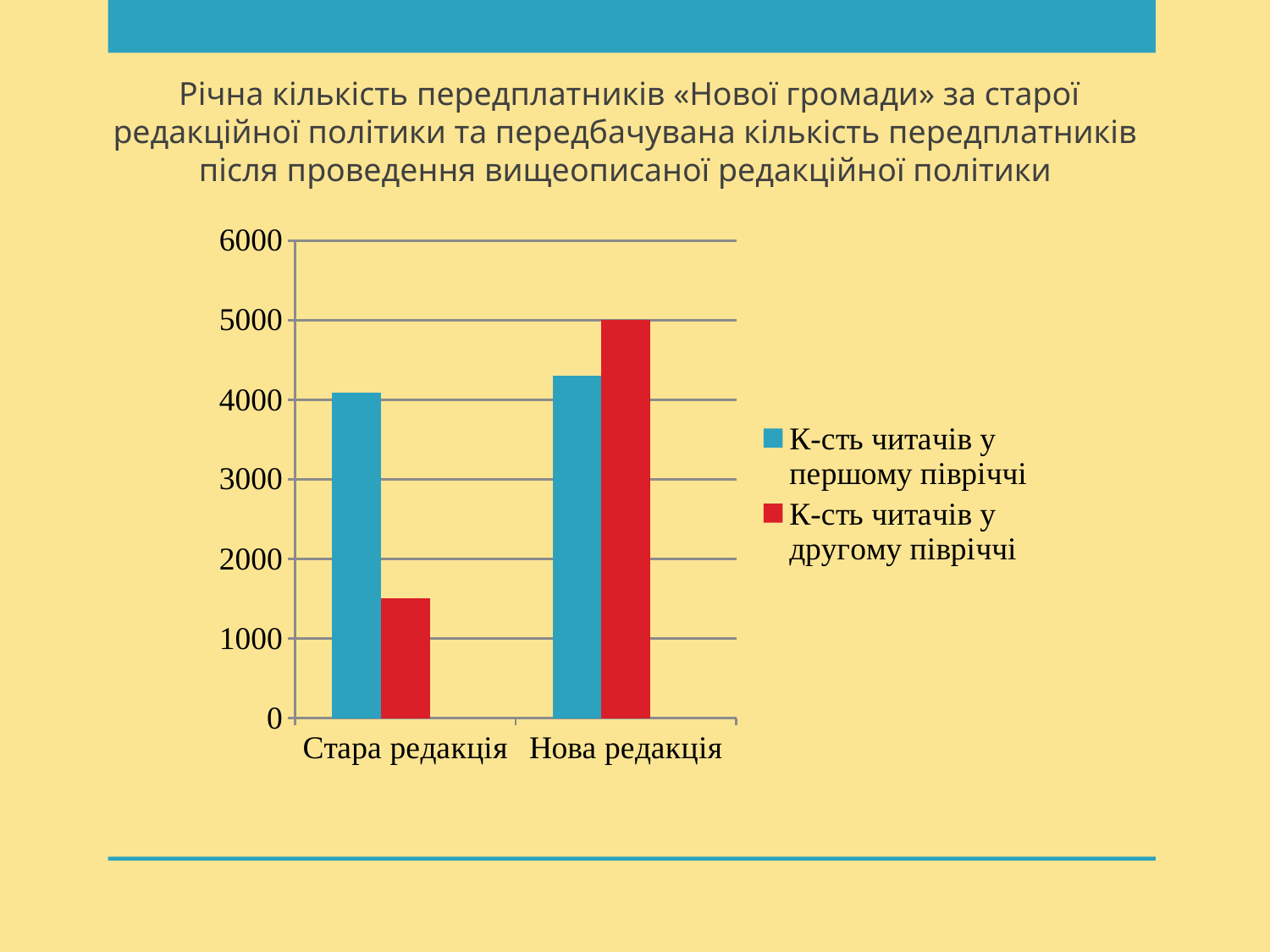
Which bar in the chart is the highest? К-сть читачів у другому півріччі for Нова редакція Which colour represents 'К-сть читачів у другому півріччі' in the chart's legend? red Is the value of 'К-сть читачів у першому півріччі' for 'Нова редакція' greater or less than 4000? greater What is the value of 'К-сть читачів у другому півріччі' for 'Нова редакція'? 5000 What kind of chart is shown on the slide? bar chart Which bar in the chart is the lowest? К-сть читачів у другому півріччі for Стара редакція How many categories are shown on the x axis of the chart? 2 For 'Стара редакція', which is larger: 'К-сть читачів у першому півріччі' or 'К-сть читачів у другому півріччі'? К-сть читачів у першому півріччі How many series does the chart's legend list? 2 For 'Нова редакція', which is larger: 'К-сть читачів у першому півріччі' or 'К-сть читачів у другому півріччі'? К-сть читачів у другому півріччі Is the value of 'К-сть читачів у другому півріччі' for 'Стара редакція' greater or less than 2000? less Is the value of 'К-сть читачів у першому півріччі' for 'Стара редакція' greater or less than 3000? greater